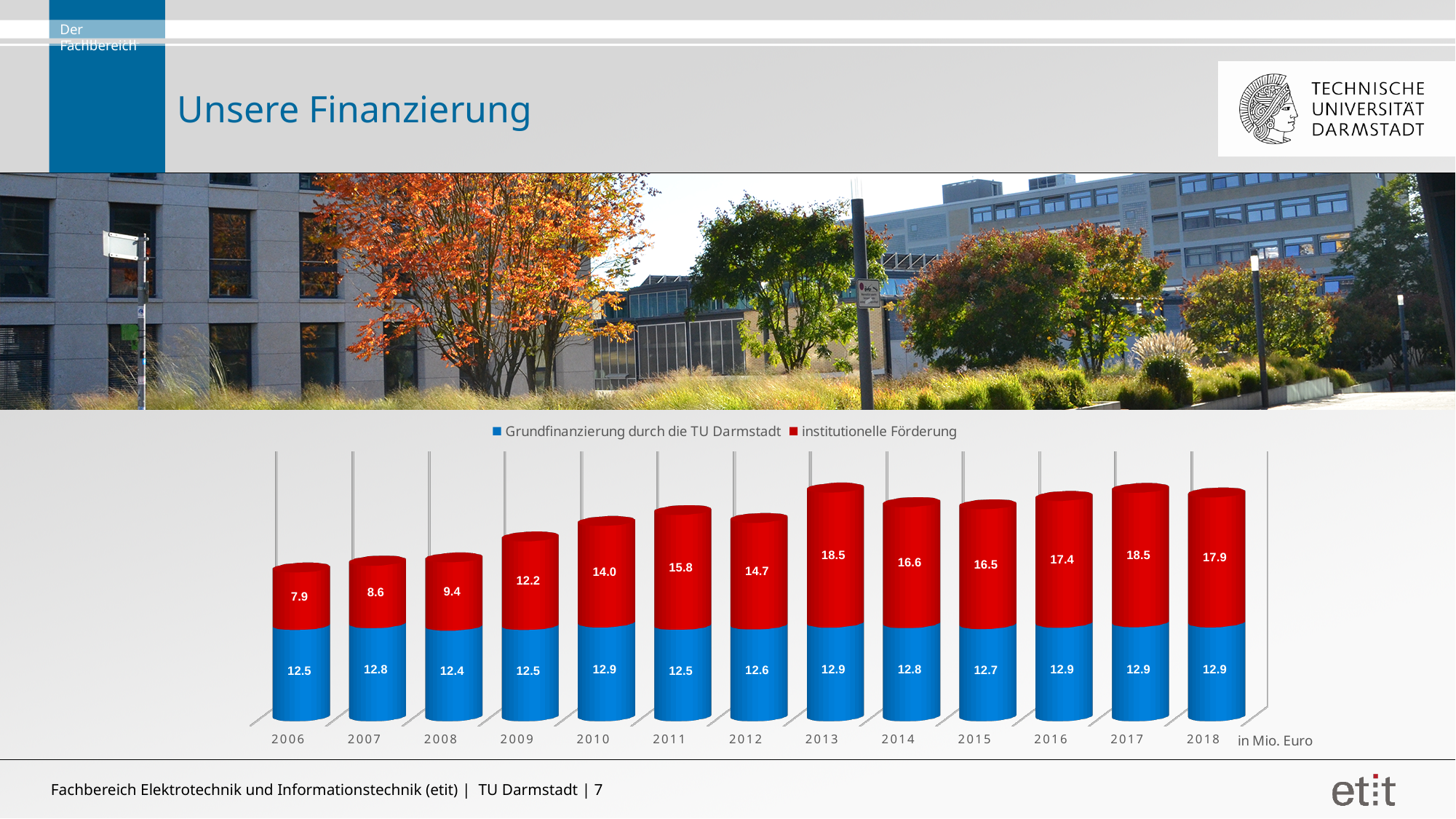
Does institutionelle Förderung generally rise or fall from 2006 to 2013? rise In which year is institutionelle Förderung lowest? 2006 How many years are shown on the x axis? 13 How many series does the legend list? 2 What is the total funding (both series combined) in 2006? 20.4 In 2018, which is larger: institutionelle Förderung or Grundfinanzierung durch die TU Darmstadt? institutionelle Förderung What is the value of Grundfinanzierung durch die TU Darmstadt in 2008? 12.4 What type of chart is shown on the slide? stacked bar chart What is the total funding (both series combined) in 2018? 30.8 What is the value of institutionelle Förderung in 2010? 14.0 What is the difference between institutionelle Förderung in 2013 and in 2006? 10.6 What unit is stated for the values in the chart? in Mio. Euro